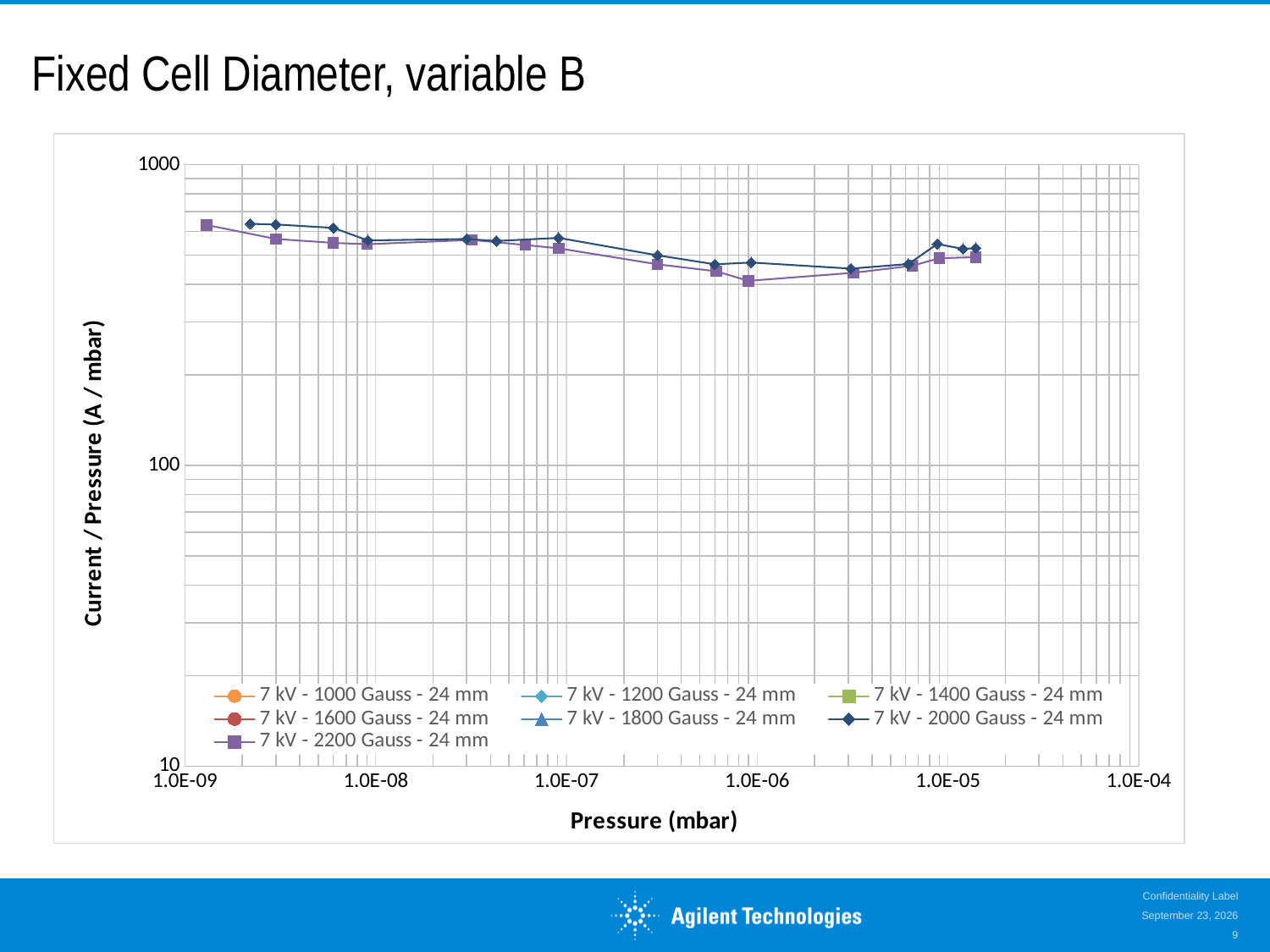
Is the value for the 7 kV - 2000 Gauss - 24 mm series at a pressure of 1.0E-06 mbar greater or less than 100? greater Is the value for the 7 kV - 2000 Gauss - 24 mm series at its first point near 1.0E-09 mbar greater or less than 100? greater At a pressure of 1.0E-06 mbar, which series has the larger value: 7 kV - 2000 Gauss - 24 mm or 7 kV - 2200 Gauss - 24 mm? 7 kV - 2000 Gauss - 24 mm Do the values for the 7 kV - 2200 Gauss - 24 mm series rise or fall between 1.0E-09 mbar and 1.0E-06 mbar? fall Is the value for the 7 kV - 2200 Gauss - 24 mm series at a pressure of 1.0E-06 mbar greater or less than 1000? less What is the title of the x axis? Pressure (mbar) Which series is plotted with square markers? 7 kV - 2200 Gauss - 24 mm What kind of chart is shown on the slide? line chart How many series does the legend list? 7 What is the title of the y axis? Current / Pressure (A / mbar)